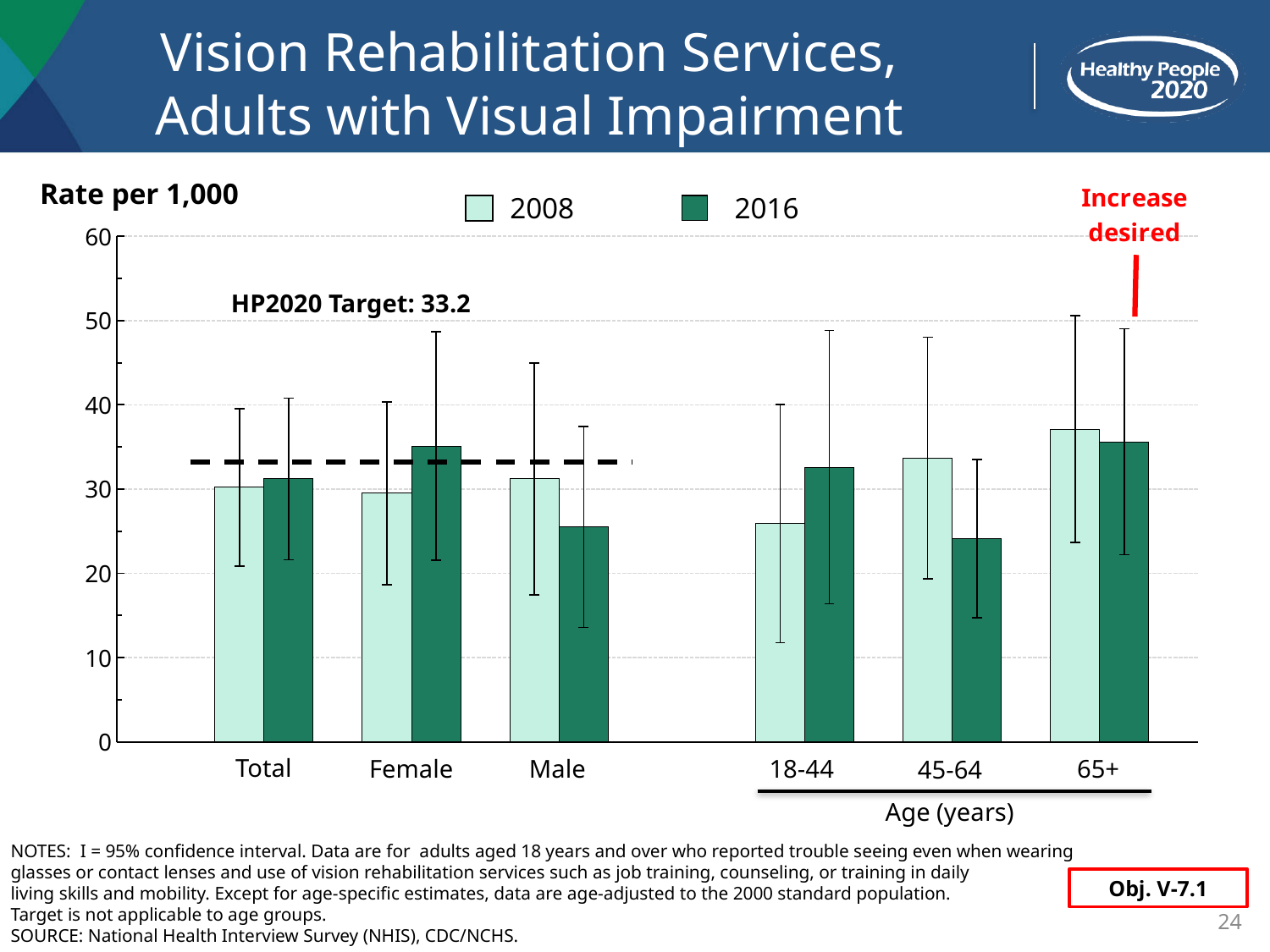
Is the 2016 value for Female greater or less than 30? greater Is the 2008 value for 18-44 greater or less than 30? less How many series does the legend list? 2 How many categories are shown along the x axis? 6 Is the 2016 value for Male greater or less than 30? less What kind of chart is shown on the slide? bar chart For the 45-64 age group, which year has the larger value, 2008 or 2016? 2008 What is the HP2020 Target value shown on the chart? 33.2 Which two years are listed in the legend? 2008 and 2016 Which category has the highest 2008 value? 65+